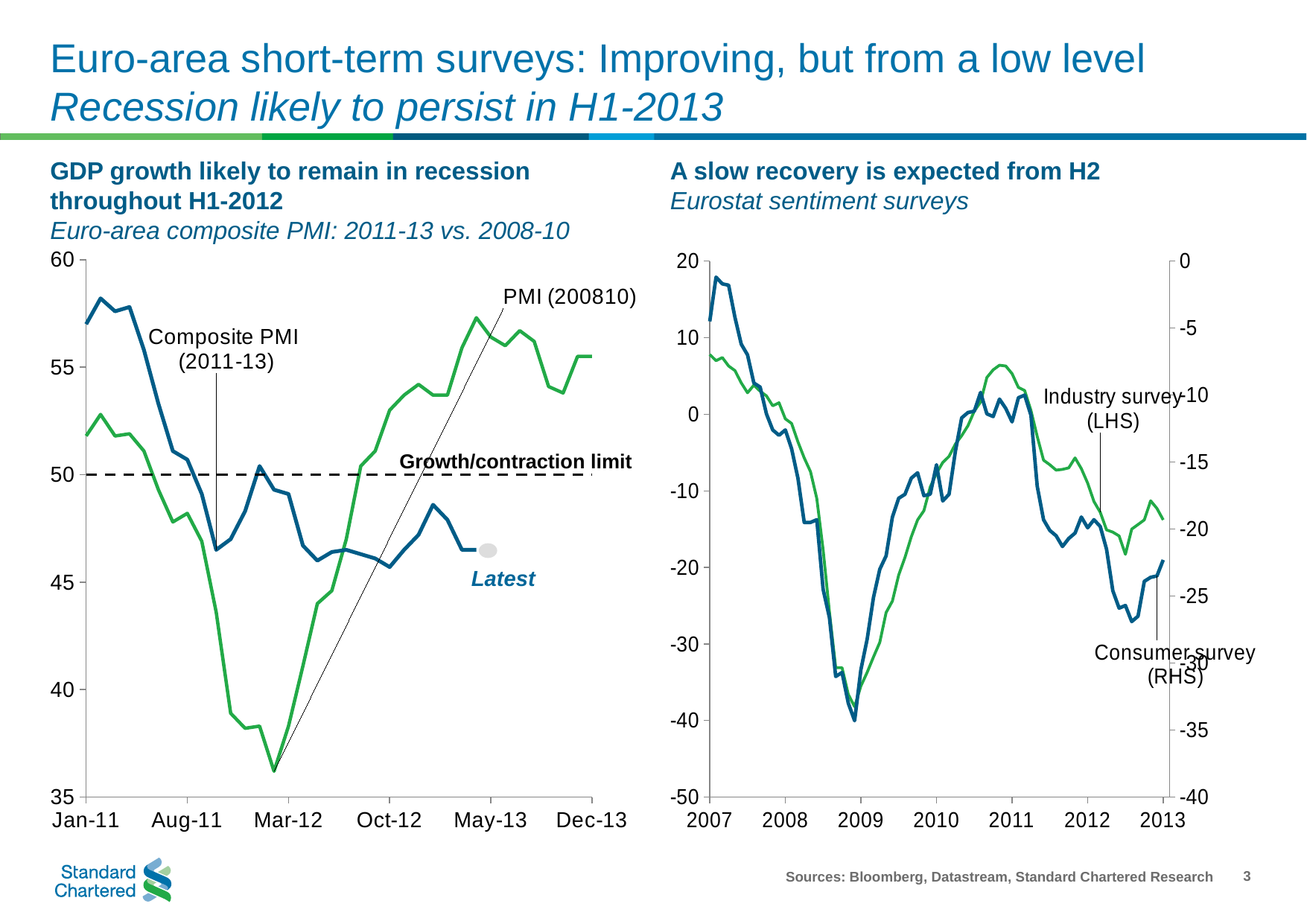
In the right chart, in which year do both the Industry survey and Consumer survey reach their lowest points? 2009 What kind of chart is the left chart, 'Euro-area composite PMI: 2011-13 vs. 2008-10'? line chart In the right chart, is the lowest point of the Industry survey (LHS) series greater or less than -30? less In the left chart, how many data series are plotted (excluding the dashed limit line)? 2 In the right chart, how many data series are plotted? 2 What kind of chart is the right chart, 'Eurostat sentiment surveys'? line chart In the left chart, what value does the dashed 'Growth/contraction limit' line sit at? 50 In the left chart, is the Composite PMI (2011-13) value at Jan-11 greater or less than 55? greater In the left chart, is the lowest point of the PMI (200810) series greater or less than 40? less In the right chart, which axis is the Consumer survey plotted against? RHS (right-hand side) In the left chart, does the Composite PMI (2011-13) series end higher or lower than where it starts at Jan-11? lower